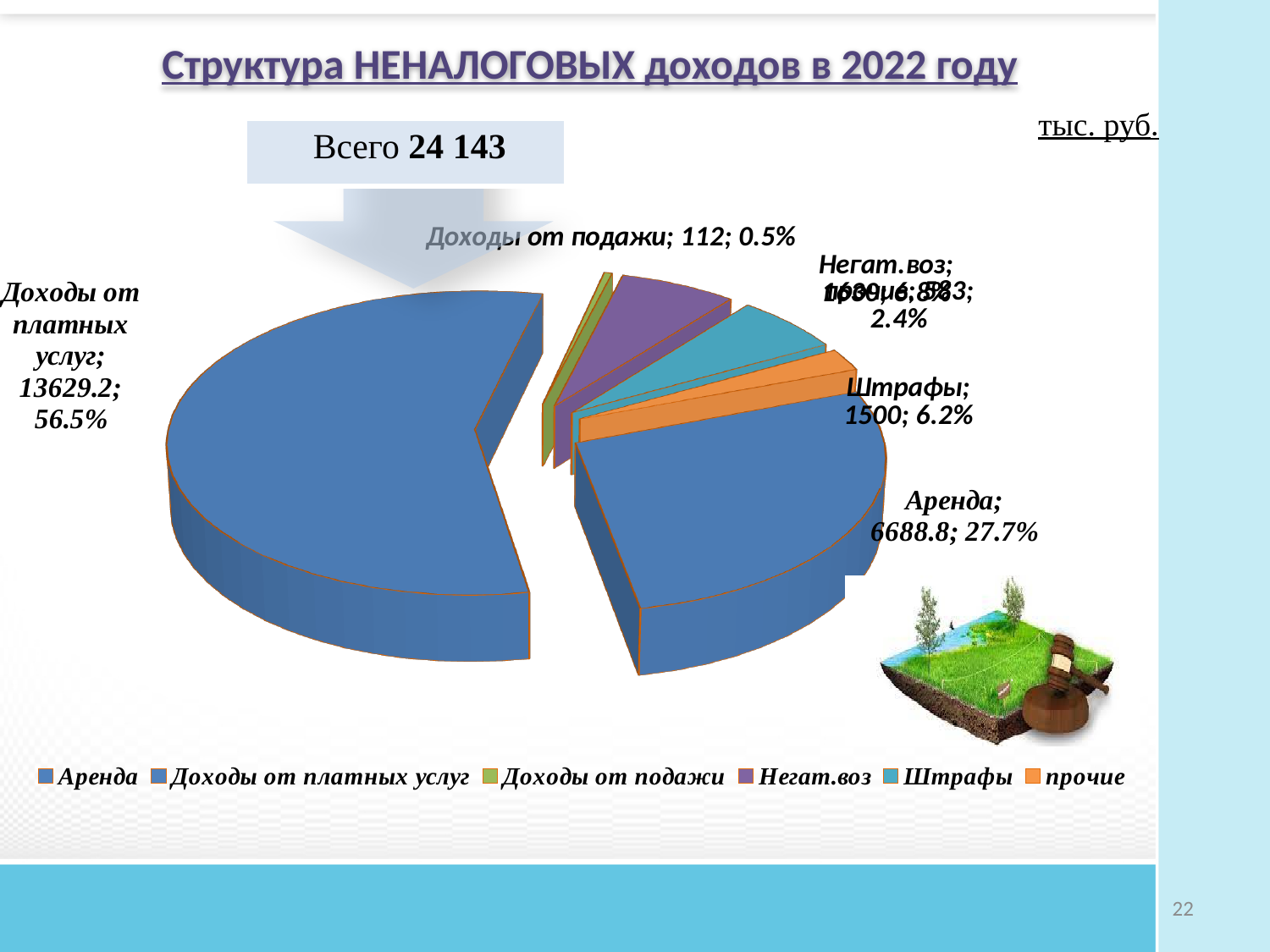
What is the value for Доходы от платных услуг? 13629.2 What kind of chart is shown on the slide? pie chart What is the value for Штрафы? 1500 What share of the pie does Доходы от подажи represent? 0.5% How many categories does the legend list? 6 What share of the pie does Доходы от платных услуг represent? 56.5% Which category has the smallest slice of the pie? Доходы от подажи What share of the pie does Аренда represent? 27.7% What is the value for Аренда in the pie chart? 6688.8 Which is larger, Аренда or Штрафы? Аренда What is the difference between the values for Доходы от платных услуг and Аренда? 6940.4 Which category has the largest slice of the pie? Доходы от платных услуг